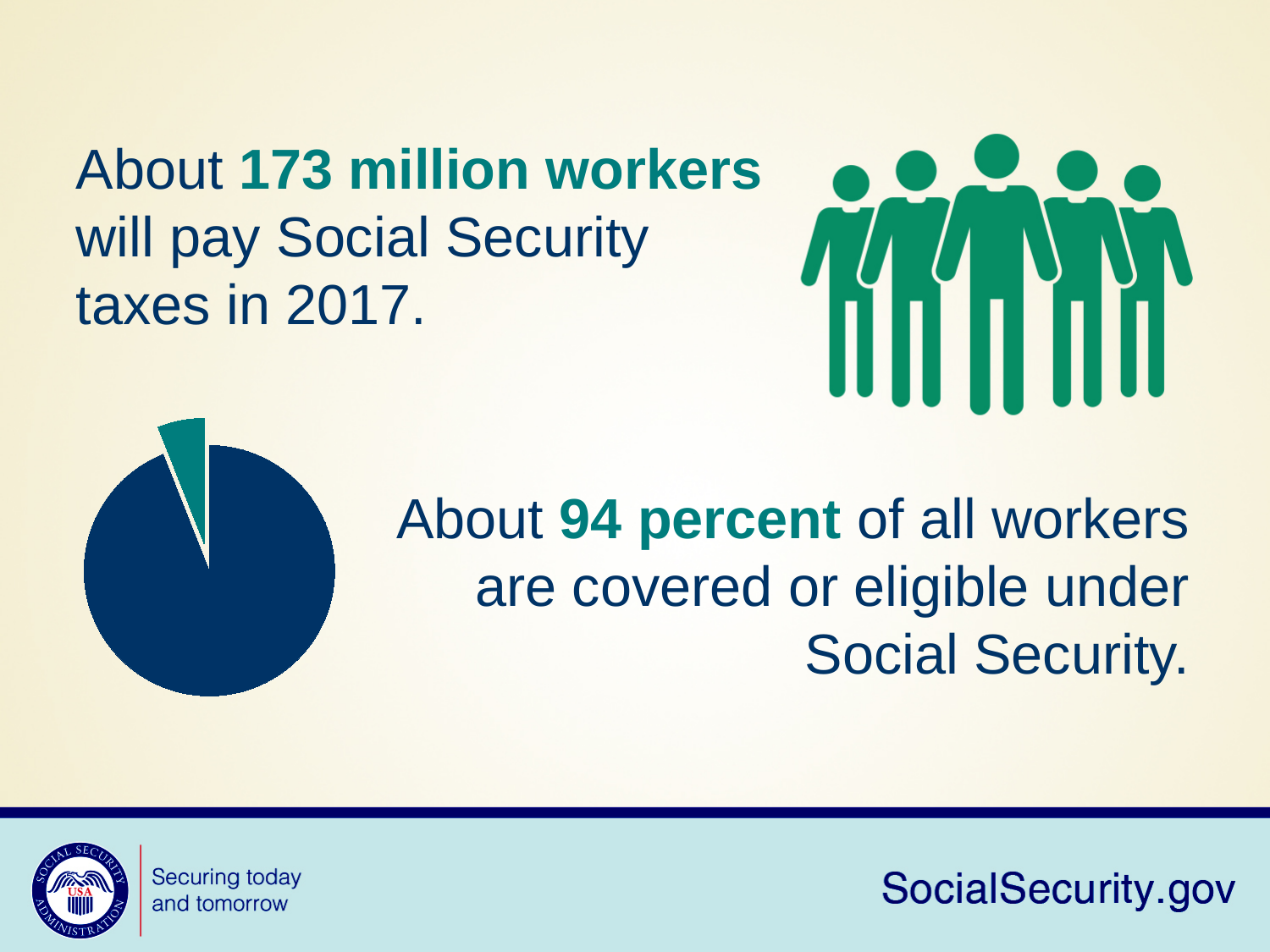
How many slices does the pie chart have? 2 Is the dark blue slice of the pie chart greater or less than 50% of the pie? greater What colour is the small, separated slice of the pie chart? Teal Does the pie chart have a legend? No According to the slide text, what share of all workers does the large slice of the pie represent? 94 percent What kind of chart is shown on the slide? Pie chart Which slice of the pie chart is the smallest? The teal slice Which slice of the pie chart is larger, the dark blue one or the teal one? The dark blue one Is the teal slice of the pie chart greater or less than 25% of the pie? less